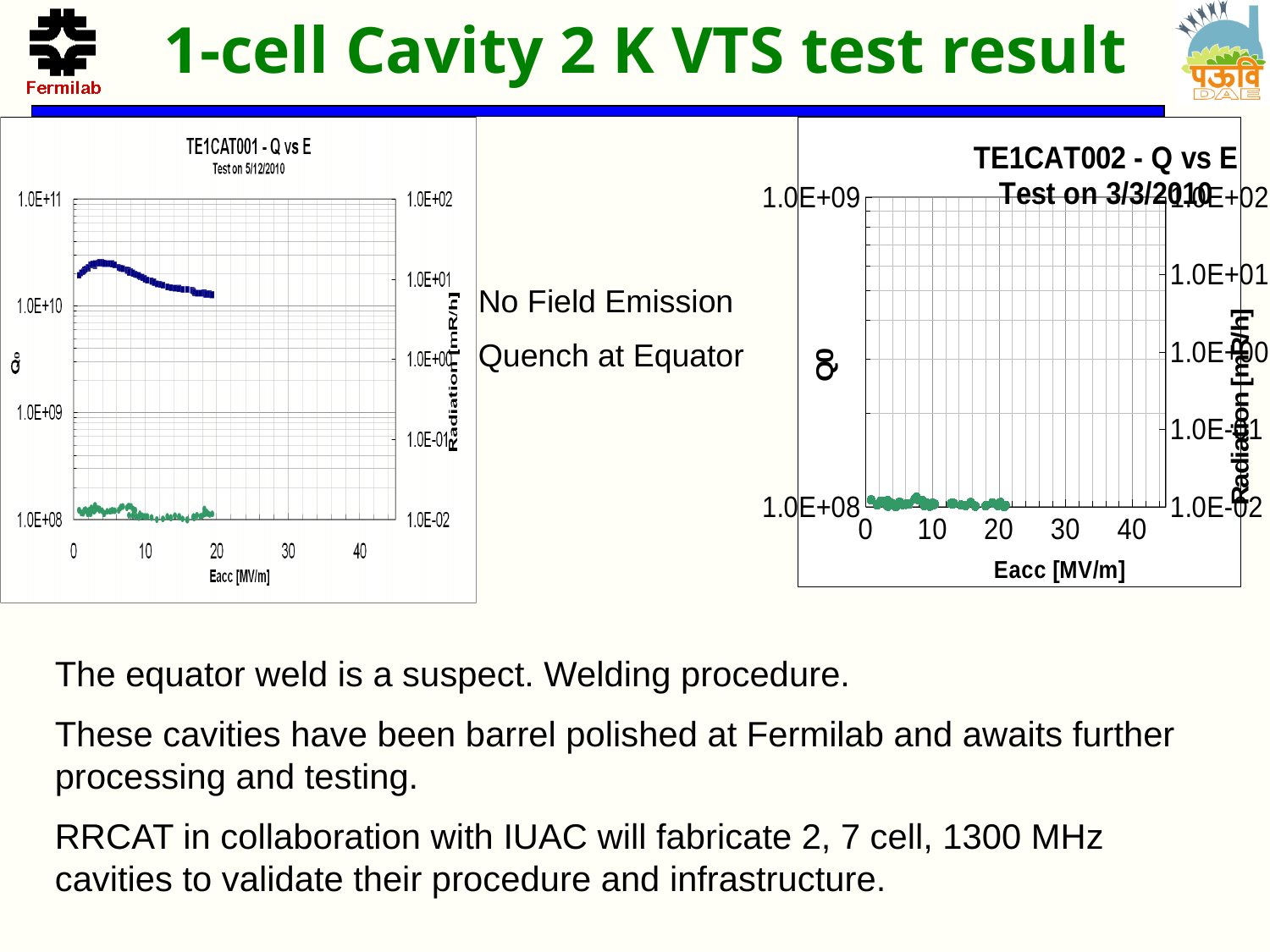
In the left chart 'TE1CAT001 - Q vs E', do the Q0 values fall or rise as Eacc increases from 5 MV/m to 20 MV/m? fall On what date was the test shown in the right chart 'TE1CAT002 - Q vs E' performed, according to its title? 3/3/2010 In the left chart 'TE1CAT001 - Q vs E', are the radiation values (green points) greater or less than 1.0E-01 mR/h? less What is the highest tick value on the left y-axis (Q0) of the right chart 'TE1CAT002 - Q vs E'? 1.0E+09 In the left chart 'TE1CAT001 - Q vs E', does the Q0 value at Eacc = 10 MV/m lie above or below 1.0E+10? greater What kind of chart is the left chart titled 'TE1CAT001 - Q vs E'? Scatter plot In the left chart 'TE1CAT001 - Q vs E', is the highest Eacc reached by the data greater or less than 30 MV/m? less What is the x-axis label of the right chart titled 'TE1CAT002 - Q vs E'? Eacc [MV/m] What is the lowest tick value on the right y-axis (Radiation) of the left chart 'TE1CAT001 - Q vs E'? 1.0E-02 What is the highest tick value on the x-axis of the left chart 'TE1CAT001 - Q vs E'? 40